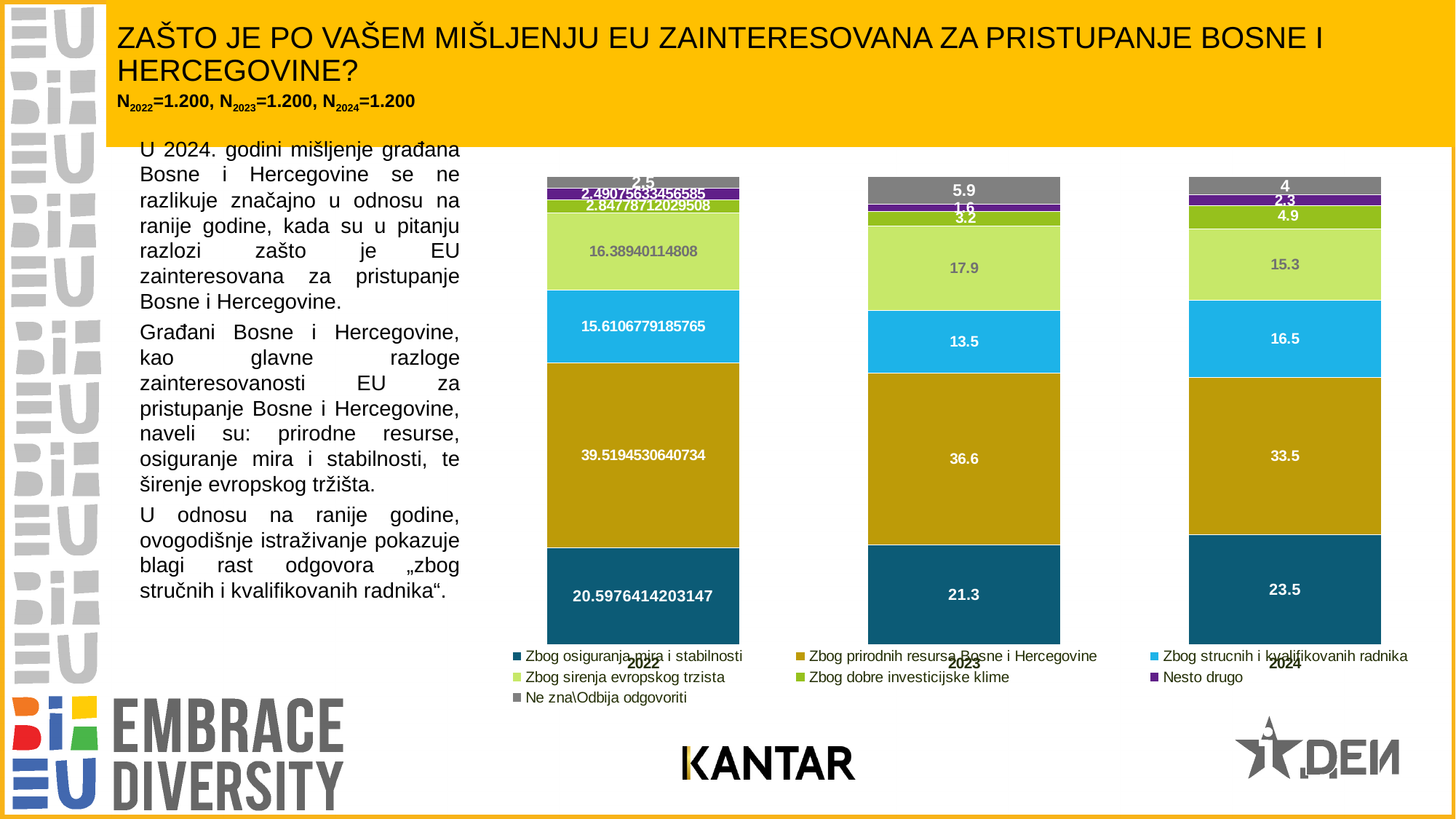
What is the value for "Zbog osiguranja mira i stabilnosti" in 2023? 21.3 Does the value for "Zbog prirodnih resursa Bosne i Hercegovine" rise or fall from 2023 to 2024? Fall How many series does the legend list? 7 Which is larger in 2024: "Zbog strucnih i kvalifikovanih radnika" or "Zbog sirenja evropskog trzista"? Zbog strucnih i kvalifikovanih radnika What is the value for "Zbog strucnih i kvalifikovanih radnika" in 2024? 16.5 What is the value for "Ne zna\Odbija odgovoriti" in 2023? 5.9 Which reason has the largest segment in the 2024 bar? Zbog prirodnih resursa Bosne i Hercegovine What is the value for "Zbog prirodnih resursa Bosne i Hercegovine" in 2024? 33.5 What kind of chart is shown on the slide? Stacked bar chart What is the difference between the 2024 and 2023 values for "Zbog osiguranja mira i stabilnosti"? 2.2 How many years (bars) are shown in the chart? 3 Which reason has the smallest segment in the 2023 bar? Nesto drugo